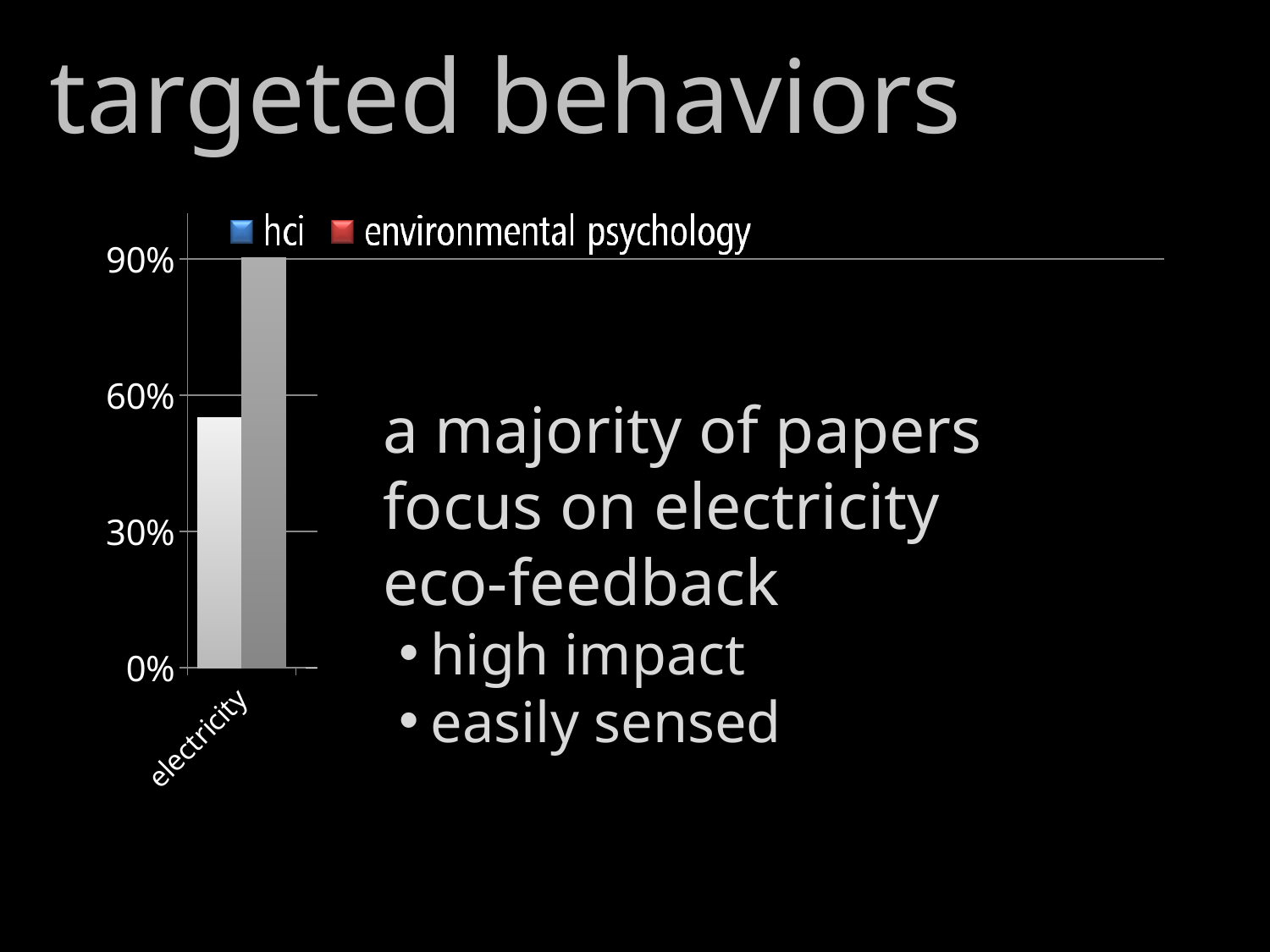
What is the category label shown on the x axis of the chart? electricity How many series does the chart's legend list? 2 Which series has the highest bar in the chart? environmental psychology Is the value for environmental psychology in the electricity category greater or less than 60%? greater What kind of chart is shown on the slide? bar chart Is the value for hci in the electricity category greater or less than 60%? less Which series has the larger value for electricity, hci or environmental psychology? environmental psychology Is the value for hci in the electricity category greater or less than 30%? greater How many categories are shown on the x axis of the chart? 1 What are the two entries in the chart's legend? hci, environmental psychology Which series has the lowest bar in the chart? hci